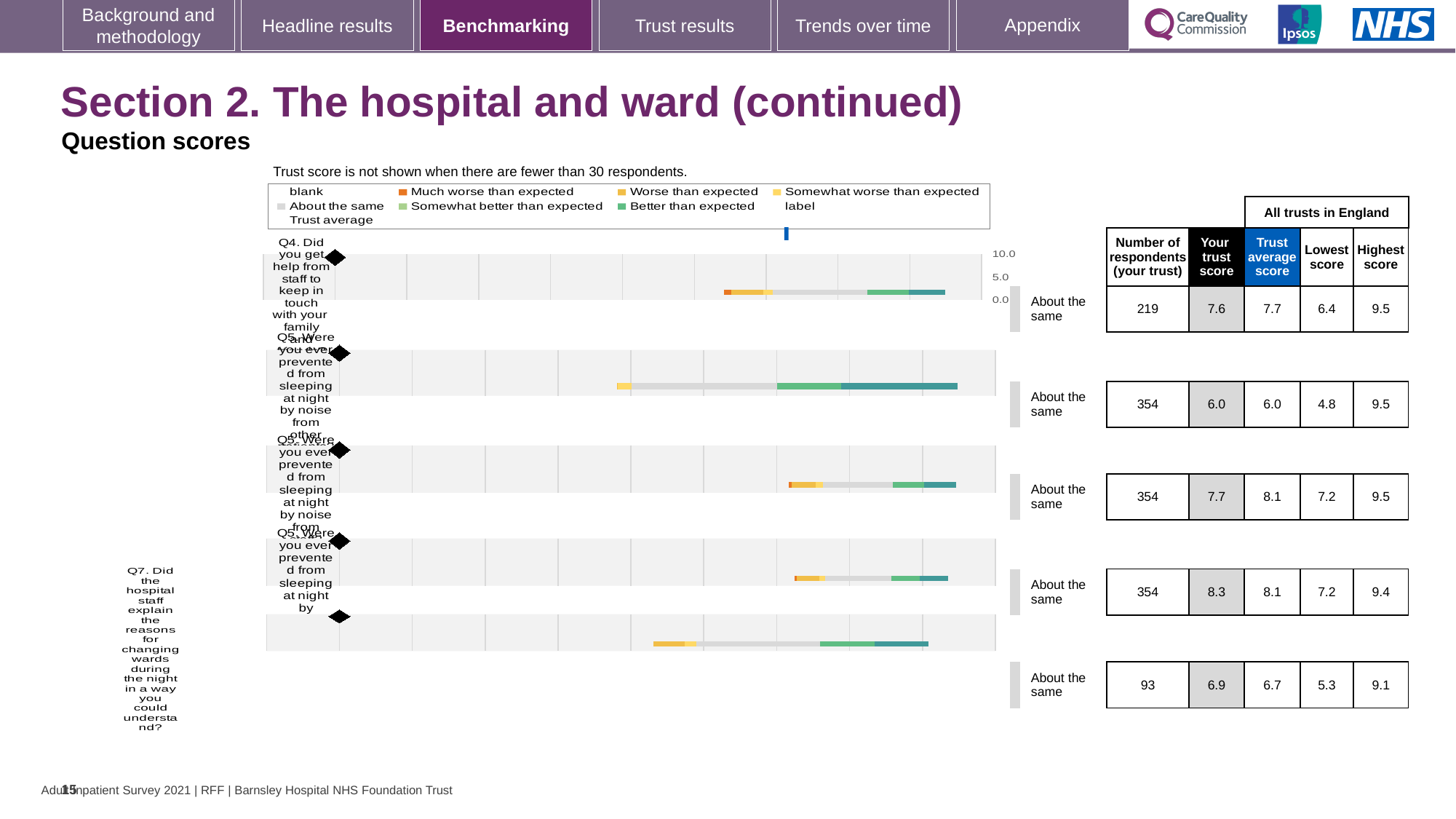
How many question rows (bars) are plotted in the chart? 5 For Q7, which is larger: the trust's own score or the trust average score? Your trust score (6.9) What benchmark category is shown next to the Q4 bar? About the same What is the highest 'Your trust score' value shown in the table? 8.3 What kind of chart is shown on the slide? bar chart According to the note above the chart, when is the trust score not shown? When there are fewer than 30 respondents What is the 'Your trust score' for Q7 (explaining reasons for changing wards during the night)? 6.9 What is the difference between the trust average score (7.7) and the trust's own score (7.6) for Q4? 0.1 What is the 'Your trust score' for Q4 (help from staff to keep in touch with family and friends)? 7.6 How many respondents does the table show for Q4? 219 What is the highest score across all trusts in England for Q7? 9.1 What is the smallest number of respondents shown in the table? 93